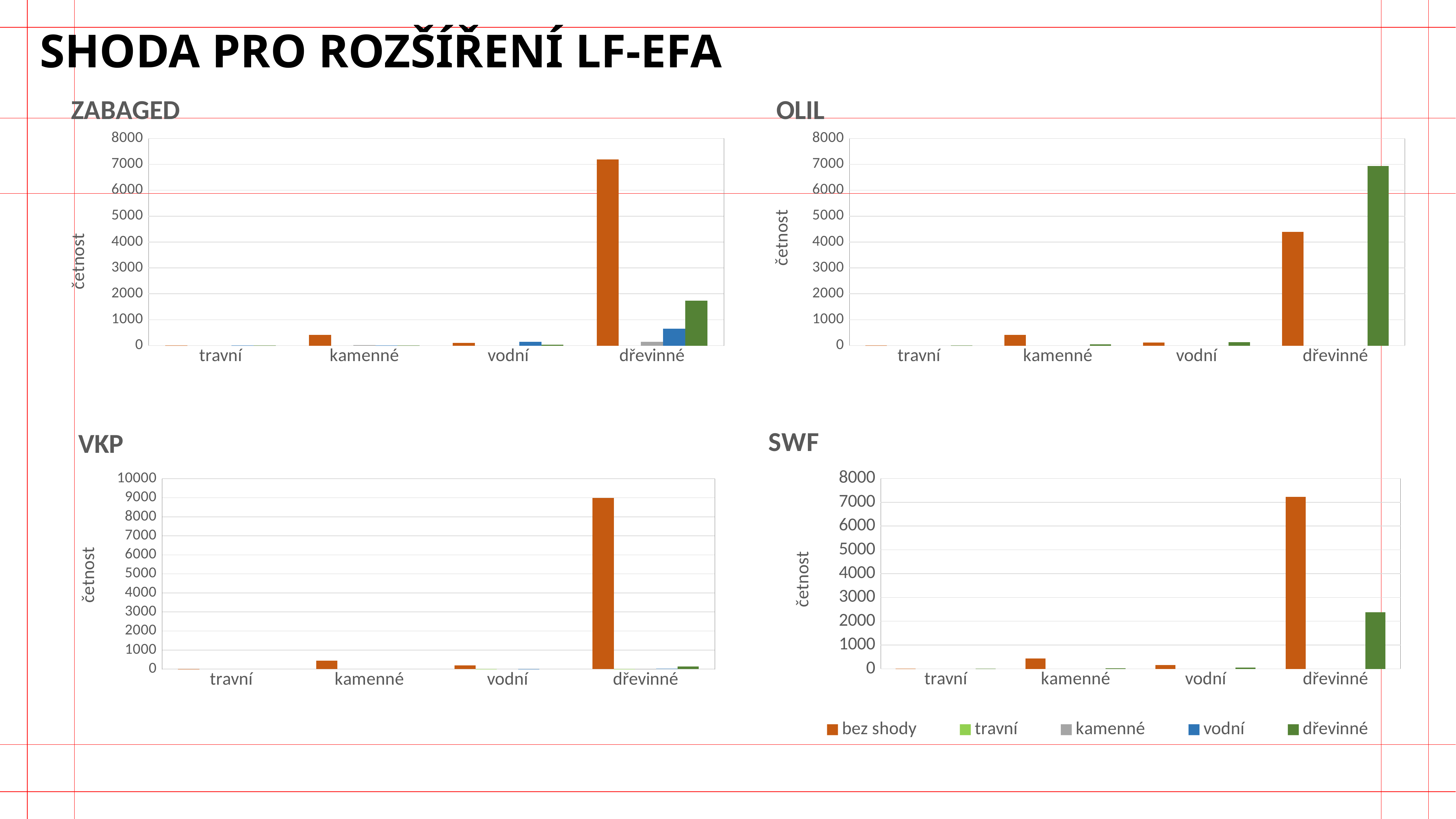
How many series does the legend at the bottom of the slide list? 5 In the ZABAGED chart, is the dřevinné series value for dřevinné greater or less than 2000? less In the SWF chart, which category has the highest bez shody bar? dřevinné What is the label on the y axis of the SWF chart? četnost In the VKP chart, is the bez shody value for dřevinné greater or less than 8000? greater In the ZABAGED chart, is the bez shody value for dřevinné greater or less than 6000? greater In the OLIL chart, which is larger for the dřevinné category: the bez shody bar or the dřevinné series bar? dřevinné series bar How many categories are shown on the x axis of the VKP chart? 4 What kind of chart is the ZABAGED chart? bar chart